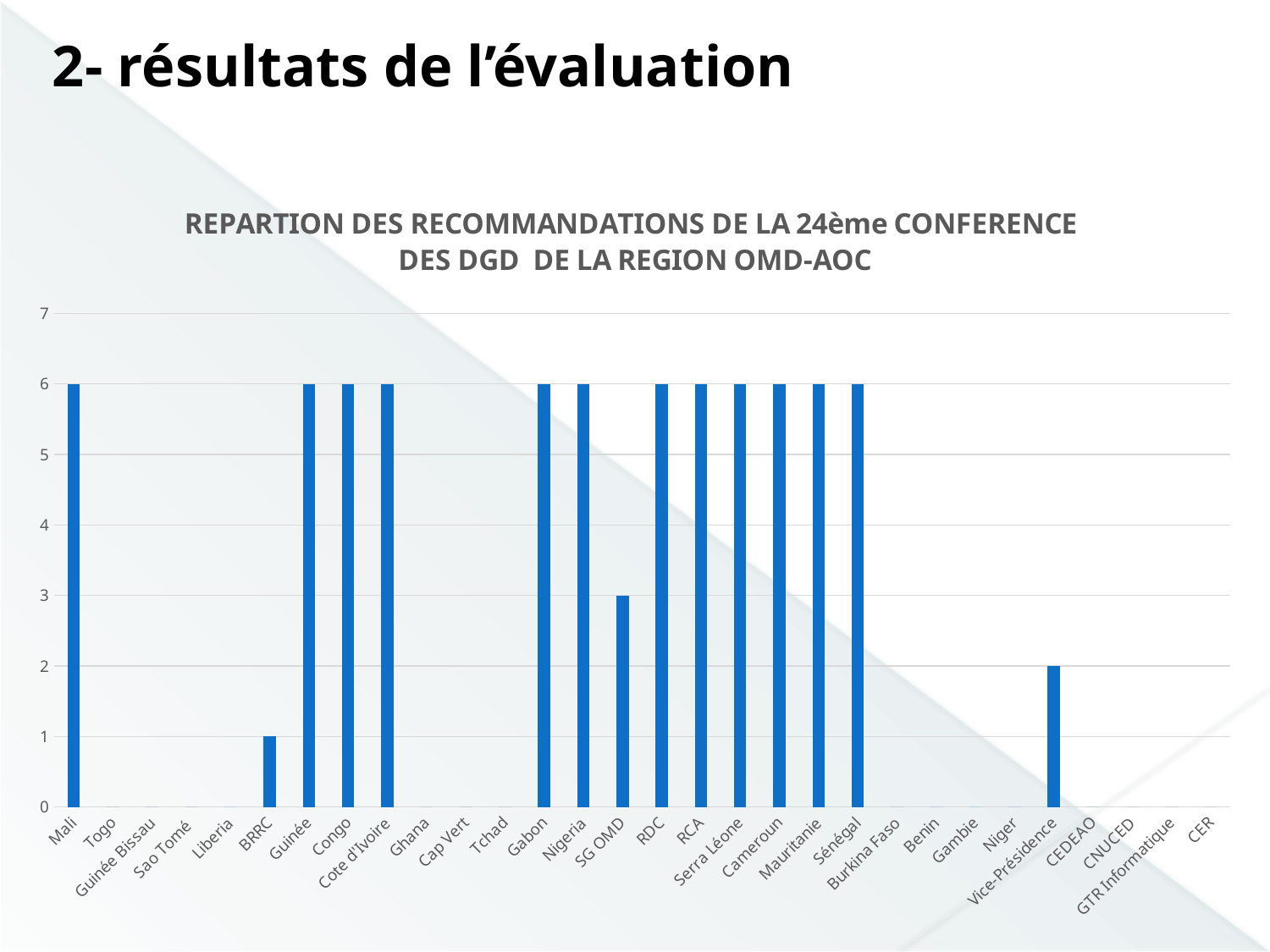
What is the difference between the values for Mali and SG OMD? 3 What is the value for Vice-Présidence? 2 What is the value for Mali? 6 Which category has the lowest non-zero value? BRRC How many categories have a value of 6? 12 Is the value for Sénégal greater or less than 5? greater What kind of chart is shown on the slide? Bar chart What is the value for BRRC? 1 What is the title of the chart? REPARTION DES RECOMMANDATIONS DE LA 24ème CONFERENCE DES DGD DE LA REGION OMD-AOC How many categories are shown on the x axis? 30 Which has a larger value, SG OMD or Vice-Présidence? SG OMD What is the value for SG OMD? 3